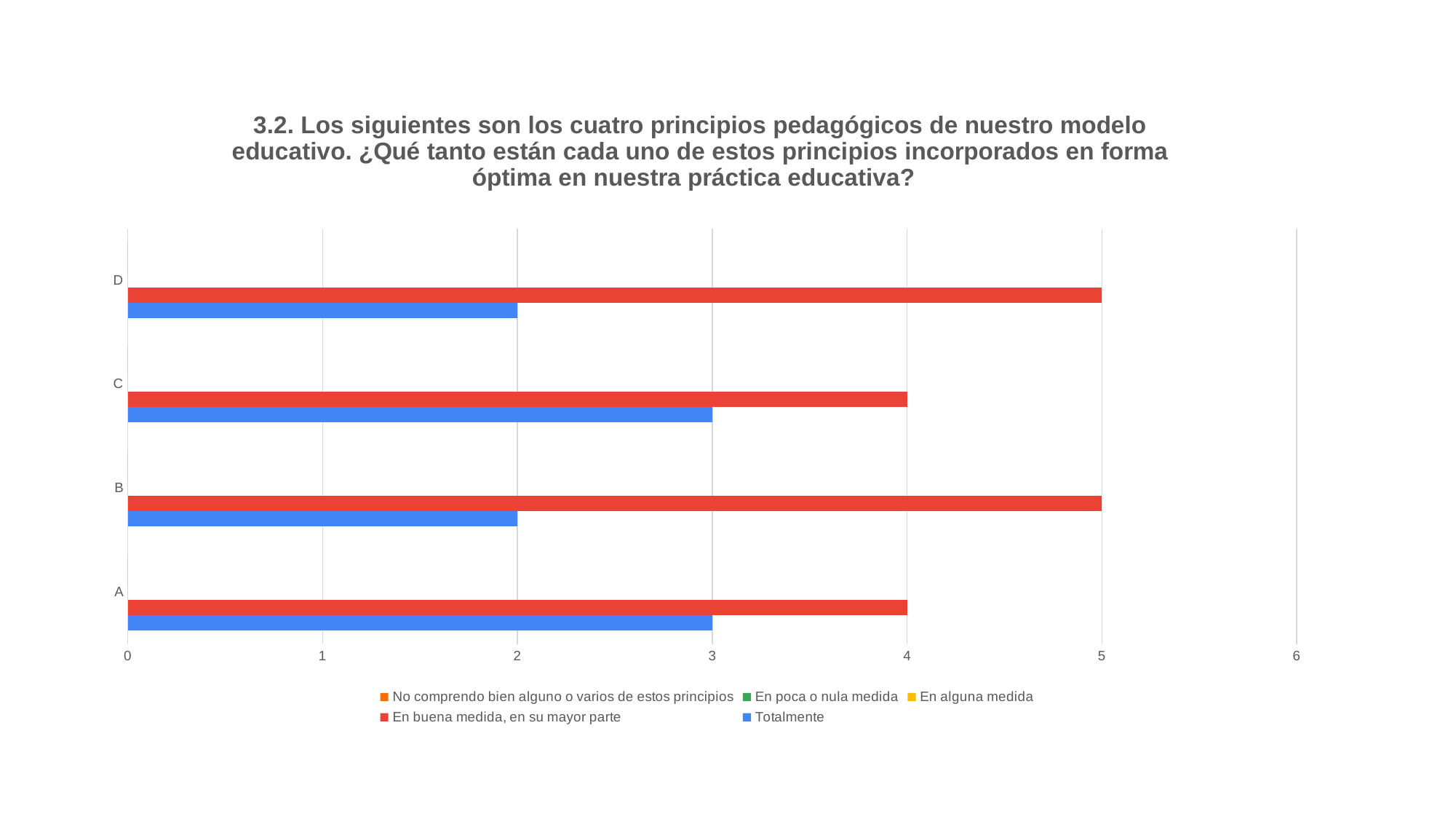
How many series does the legend list? 5 For category C, which is larger: 'En buena medida, en su mayor parte' or 'Totalmente'? En buena medida, en su mayor parte Is the value of 'En buena medida, en su mayor parte' for category B greater or less than 3? greater Which category has the lowest value for 'Totalmente'? B and D What kind of chart is shown on the slide? bar chart How many categories are shown on the vertical axis? 4 What is the value of 'En buena medida, en su mayor parte' for category D? 5 What is the value of 'Totalmente' for category B? 2 What is the value of 'En buena medida, en su mayor parte' for category A? 4 What is the value of 'Totalmente' for category C? 3 What colour represents the 'Totalmente' series? blue What is the difference between 'En buena medida, en su mayor parte' and 'Totalmente' for category D? 3